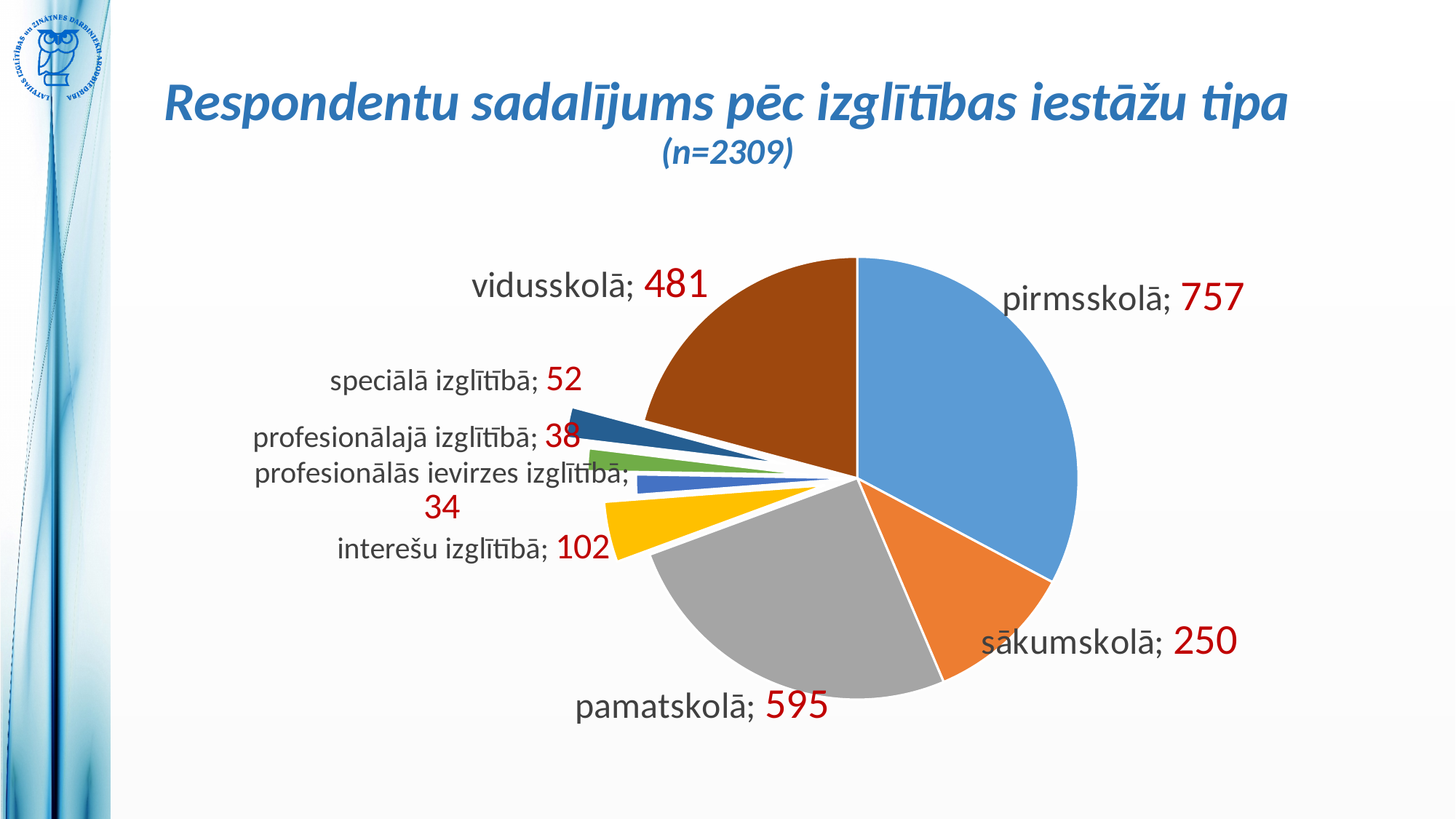
Which category has the largest slice of the pie? pirmsskolā What is the value for 'profesionālās ievirzes izglītībā'? 34 How many categories does the pie chart show? 8 What is the title of the chart on the slide? Respondentu sadalījums pēc izglītības iestāžu tipa Which category has the smallest slice of the pie? profesionālās ievirzes izglītībā What is the value for 'pamatskolā'? 595 What is the total number of respondents (n) stated under the chart title? 2309 What is the difference between the values for 'pirmsskolā' and 'vidusskolā'? 276 Which is larger, the value for 'sākumskolā' or the value for 'vidusskolā'? vidusskolā What is the value for 'interešu izglītībā'? 102 How many respondents are in the 'pirmsskolā' category? 757 What type of chart is shown on the slide? pie chart